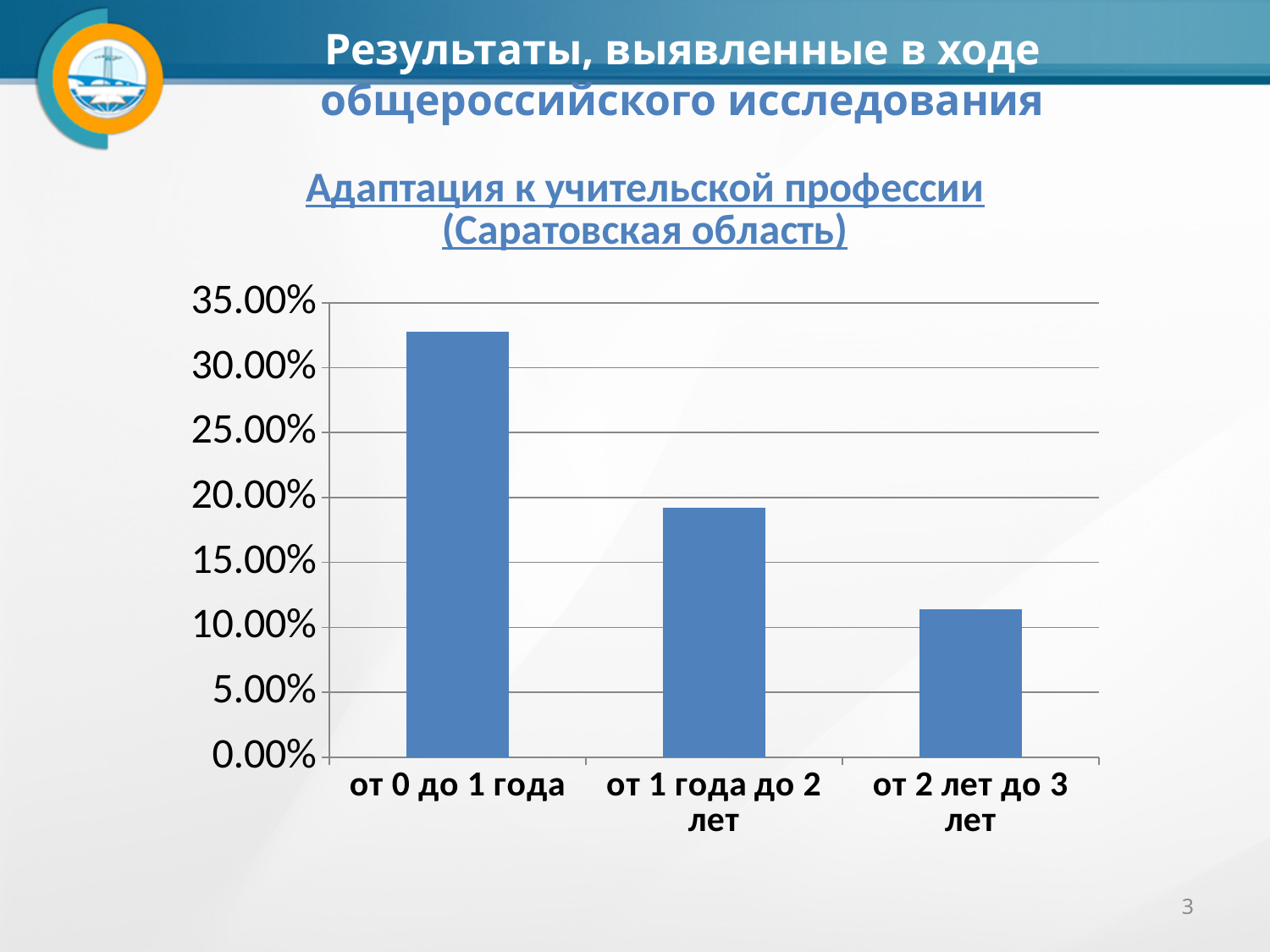
Is the value for "от 2 лет до 3 лет" greater or less than 10.00%? greater Which is larger: the value for "от 0 до 1 года" or the value for "от 1 года до 2 лет"? от 0 до 1 года How many categories are shown on the x axis of the chart? 3 What is the title of the chart? Адаптация к учительской профессии (Саратовская область) Is the value for "от 2 лет до 3 лет" greater or less than 15.00%? less Do the values rise or fall from left to right along the x axis? fall Is the value for "от 1 года до 2 лет" greater or less than 20.00%? less Which category has the highest value in the chart? от 0 до 1 года What kind of chart is shown on the slide? bar chart Which category has the lowest value in the chart? от 2 лет до 3 лет